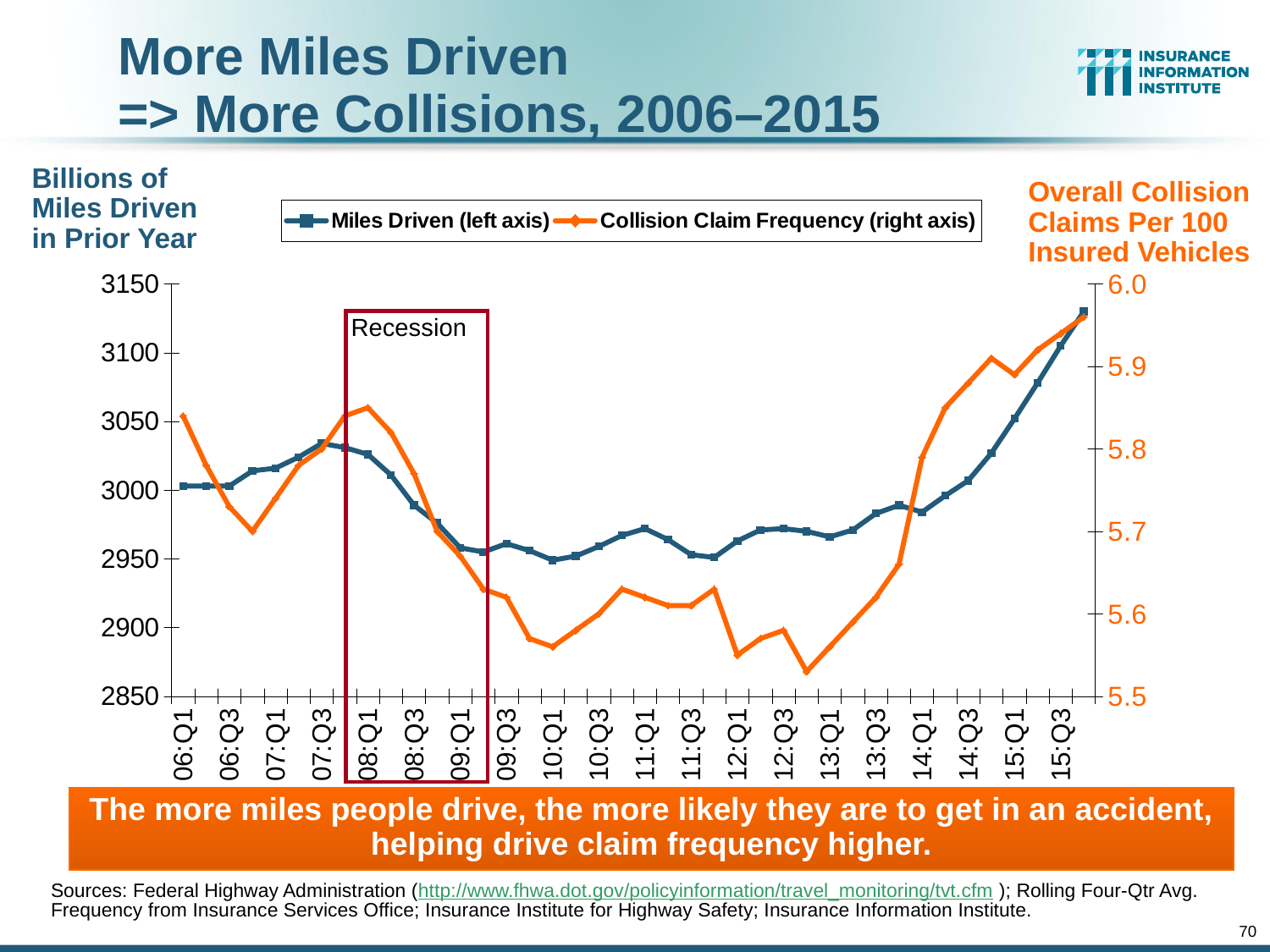
Is the Collision Claim Frequency value at 08:Q1 greater or less than 5.8? greater Is the Collision Claim Frequency value at 13:Q1 greater or less than 5.6? less What period is marked by the red box on the chart? Recession Is the Miles Driven value at 15:Q3 greater or less than 3050? greater At which quarter is the Collision Claim Frequency lowest? 12:Q4 What kind of chart is shown on the slide? Line chart Which series is plotted against the right axis? Collision Claim Frequency Does the Miles Driven series rise or fall between 13:Q3 and 15:Q3? Rise How many series does the legend list? 2 Which is larger, Miles Driven at 07:Q3 or at 10:Q1? 07:Q3